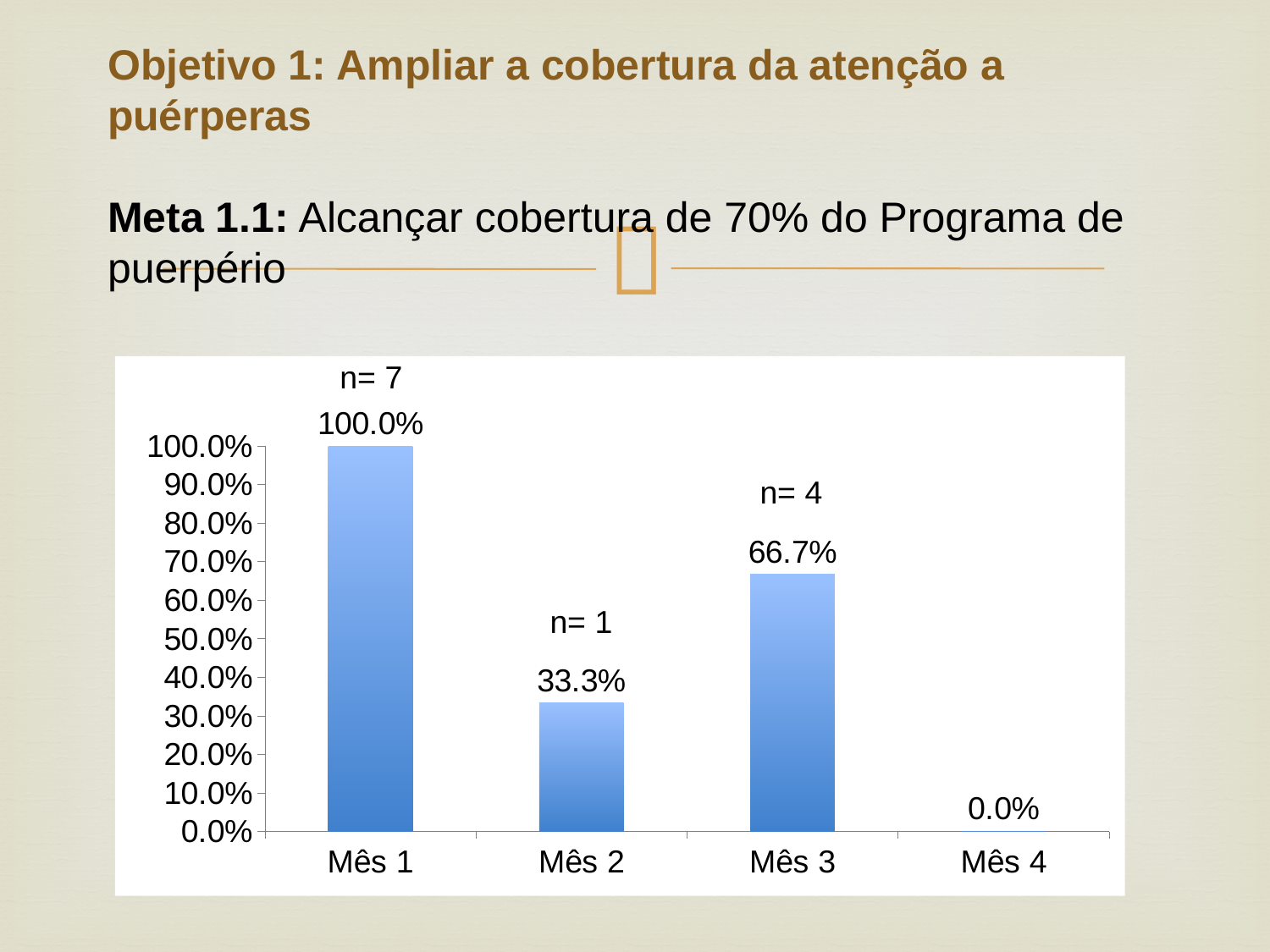
Which month has the highest value? Mês 1 What is the value for Mês 2? 33.3% What is the value for Mês 1? 100.0% How many months are shown on the x axis? 4 Which is larger, the value for Mês 2 or the value for Mês 3? Mês 3 What is the value for Mês 4? 0.0% What kind of chart is shown on the slide? bar chart What is the difference between the values for Mês 1 and Mês 3? 33.3% Which month has the lowest value? Mês 4 What is the n value shown above the bar for Mês 3? n= 4 What is the value for Mês 3? 66.7% Is the value for Mês 3 greater or less than 50.0%? greater